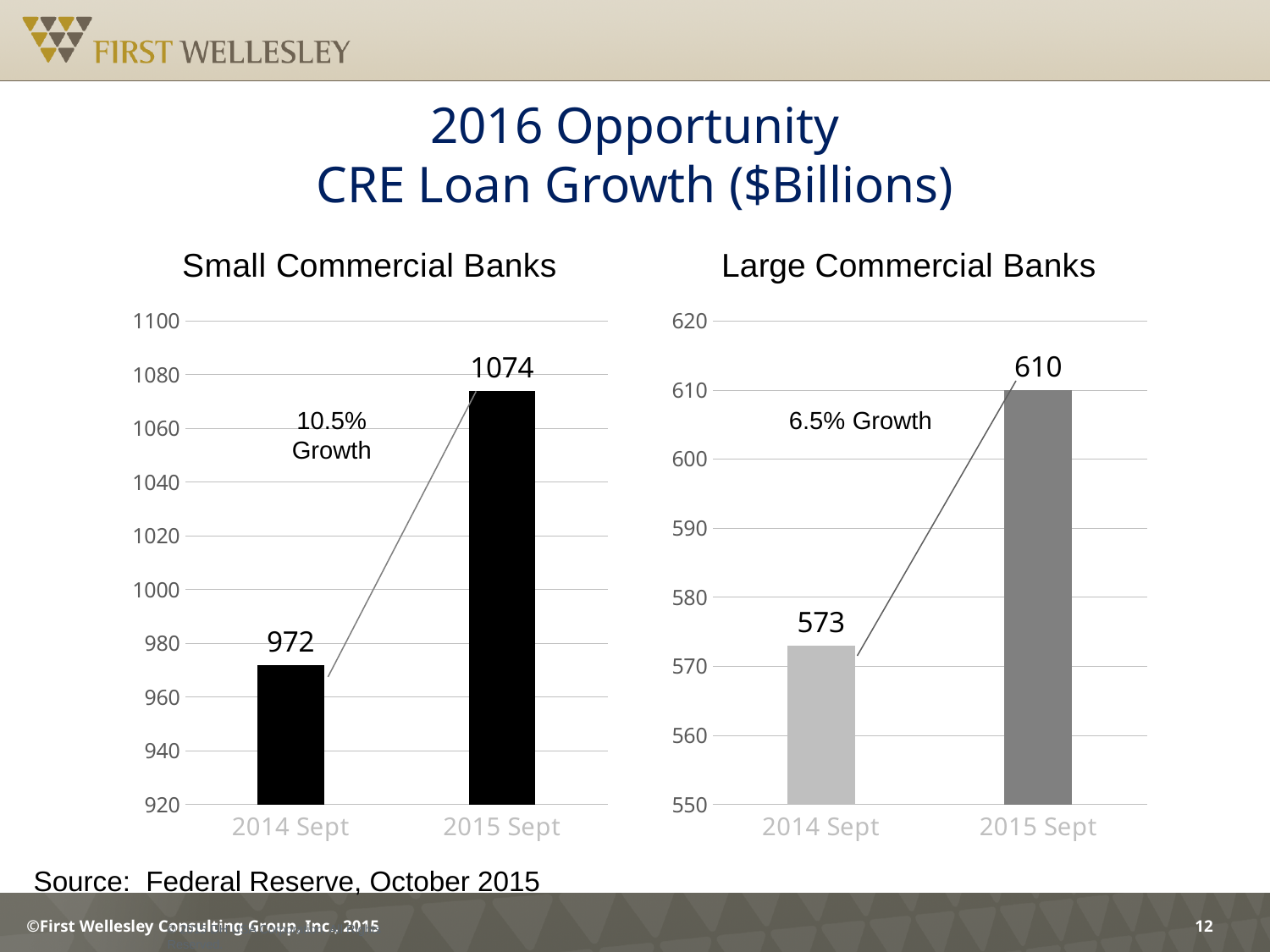
In the Small Commercial Banks chart, what is the value for 2015 Sept? 1074 In the Large Commercial Banks chart, what is the value for 2015 Sept? 610 In the Large Commercial Banks chart, what is the value for 2014 Sept? 573 In the Large Commercial Banks chart, what is the difference between the 2015 Sept and 2014 Sept values? 37 How many categories are shown on the x axis of the Large Commercial Banks chart? 2 What growth percentage is annotated on the Large Commercial Banks chart? 6.5% Growth What kind of chart is the Small Commercial Banks chart? bar chart In the Large Commercial Banks chart, which period has the higher value, 2014 Sept or 2015 Sept? 2015 Sept In the Small Commercial Banks chart, which period has the lowest value? 2014 Sept In the Small Commercial Banks chart, do the values rise or fall from 2014 Sept to 2015 Sept? rise In the Small Commercial Banks chart, what is the value for 2014 Sept? 972 In the Small Commercial Banks chart, what is the difference between the 2015 Sept and 2014 Sept values? 102